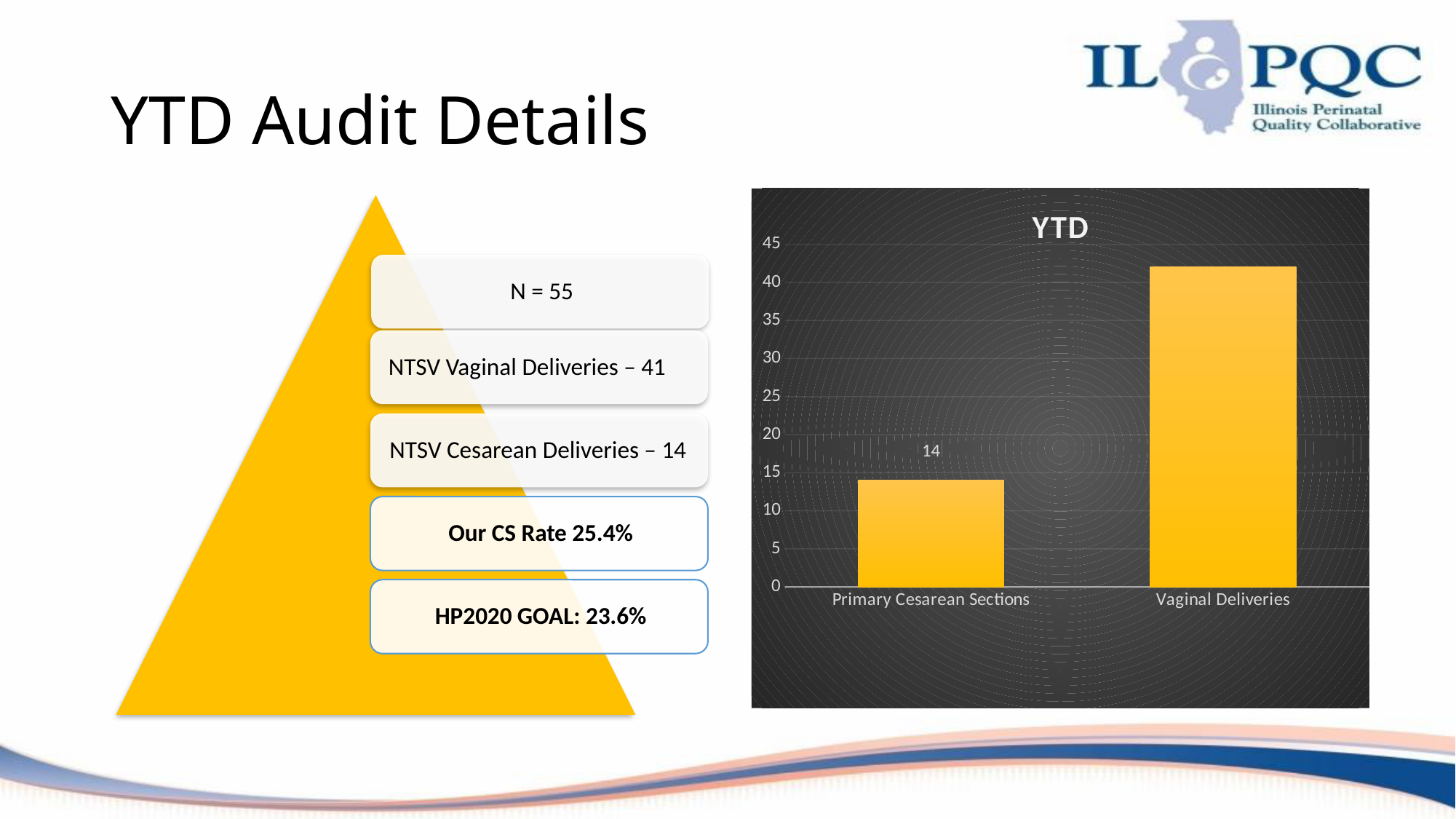
In the YTD chart, is the value for Primary Cesarean Sections greater or less than 20? less In the YTD chart, is the value for Vaginal Deliveries greater or less than 45? less Which category has the highest value in the YTD chart? Vaginal Deliveries What kind of chart is the YTD chart? bar chart In the YTD chart, which is larger: Primary Cesarean Sections or Vaginal Deliveries? Vaginal Deliveries What is the title of the chart on the slide? YTD In the YTD chart, is the value for Primary Cesarean Sections greater or less than 10? greater Which category has the lowest value in the YTD chart? Primary Cesarean Sections How many categories are shown in the YTD chart? 2 What is the highest value shown on the vertical axis of the YTD chart? 45 What is the value for Primary Cesarean Sections in the YTD chart? 14